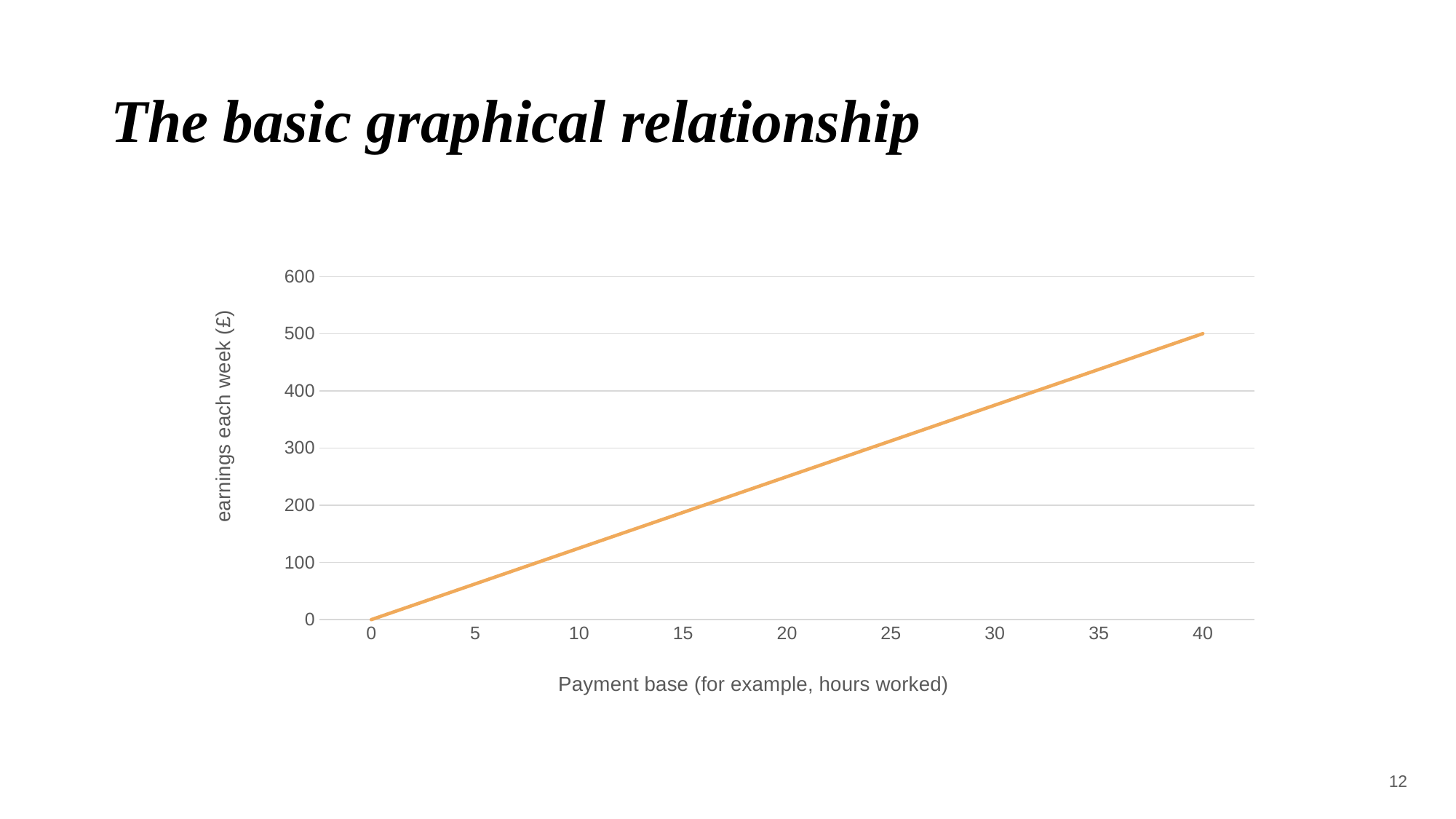
What is the title of the slide containing the chart? The basic graphical relationship Is the value of earnings each week at a payment base of 10 greater or less than 100? greater What is the difference in earnings each week between a payment base of 40 and a payment base of 0? 500 Do earnings each week rise or fall as the payment base increases along the x axis? rise What kind of chart is shown on the slide? line chart Is the value of earnings each week at a payment base of 20 greater or less than 300? less What is the label on the vertical axis of the chart? earnings each week (£) Which payment base has the higher earnings each week, 10 or 30? 30 What is the value of earnings each week when the payment base is 0? 0 Is the value of earnings each week at a payment base of 20 greater or less than 200? greater What is the value of earnings each week when the payment base is 40? 500